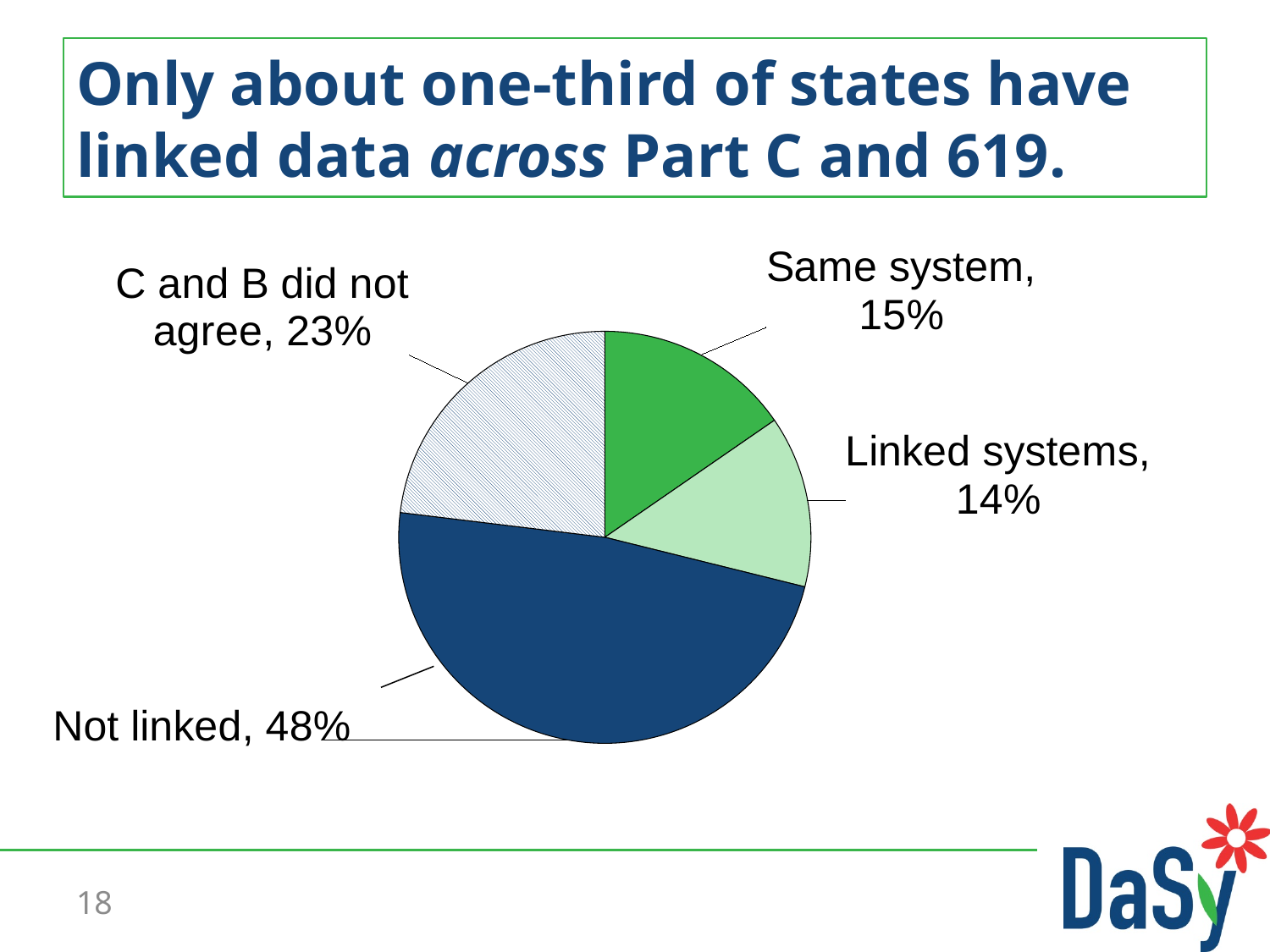
What is the difference in percentage points between 'Not linked' and 'C and B did not agree'? 25 Which category has the smallest share of the pie? Linked systems How many slices does the pie chart have? 4 What percentage of states are in the 'Same system' category? 15% Which slice of the pie is drawn with a hatched pattern? C and B did not agree What is the combined percentage of 'Same system' and 'Linked systems'? 29% What percentage of states are in the 'Not linked' category? 48% What kind of chart is shown on the slide? pie chart What percentage of states have 'Linked systems'? 14% What percentage is shown for 'C and B did not agree'? 23% Which category has the largest share of the pie? Not linked Which is larger, the share for 'Not linked' or the share for 'Same system'? Not linked